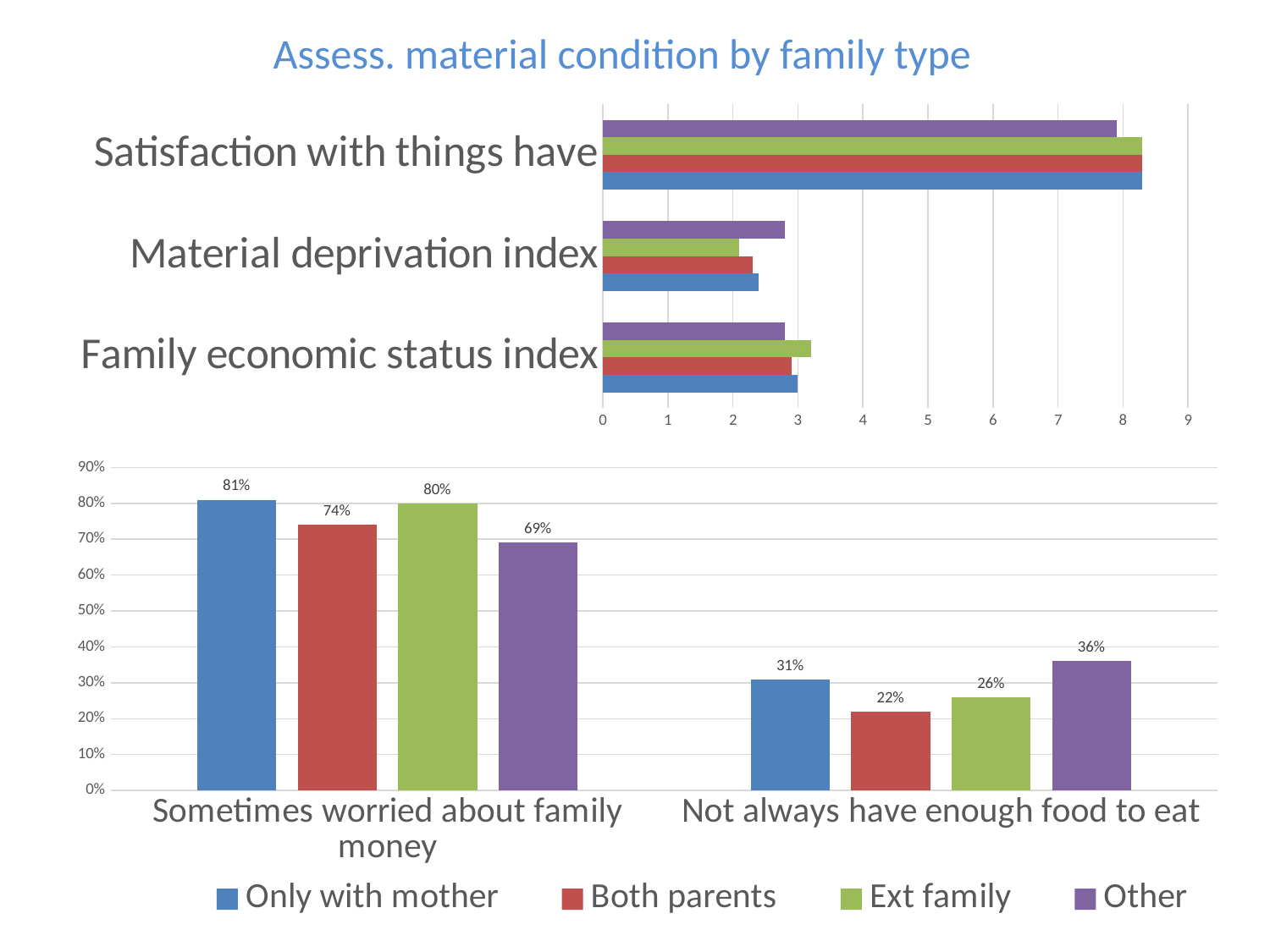
How many series does the legend of the bottom chart list? 4 In the bottom chart, what is the value for Both parents in the 'Not always have enough food to eat' category? 22% In the bottom chart, what is the value for Other in the 'Not always have enough food to eat' category? 36% How many categories are shown in the top chart titled 'Assess. material condition by family type'? 3 How many categories are shown on the x axis of the bottom chart? 2 In the bottom chart, what is the value for Only with mother in the 'Sometimes worried about family money' category? 81% In the bottom chart, which family type has the lowest value for 'Not always have enough food to eat'? Both parents What kind of chart is the top chart titled 'Assess. material condition by family type'? bar chart In the top chart, is the value of the blue bar for 'Satisfaction with things have' greater or less than 7? greater In the bottom chart, which is larger for 'Not always have enough food to eat': Ext family or Other? Other In the bottom chart, what is the difference between Only with mother and Other for 'Sometimes worried about family money'? 12% In the bottom chart, which family type has the highest value for 'Sometimes worried about family money'? Only with mother